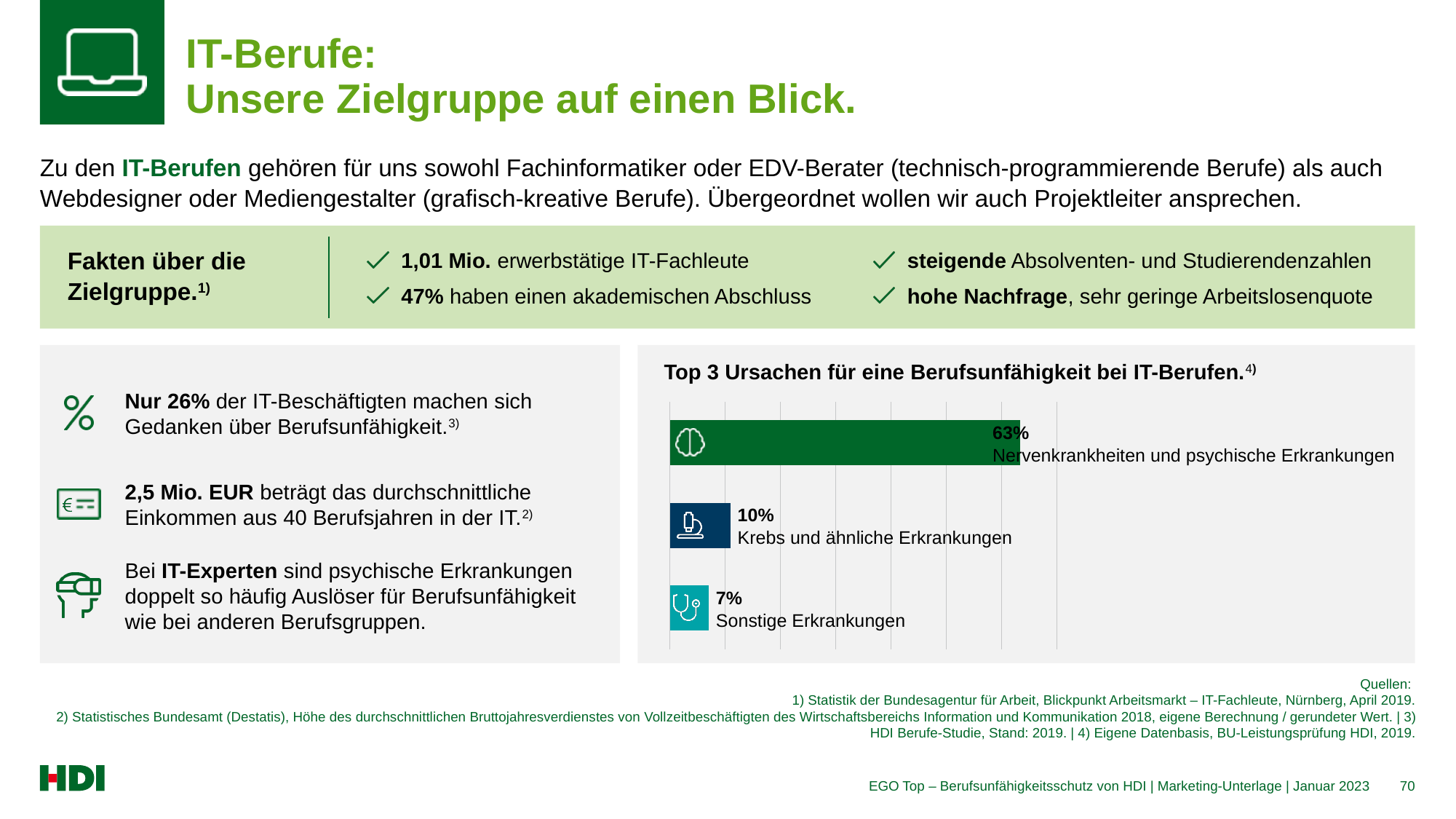
What is the value for Nervenkrankheiten und psychische Erkrankungen? 63% What is the difference between the values for Nervenkrankheiten und psychische Erkrankungen and Krebs und ähnliche Erkrankungen? 53% Which category has the highest value? Nervenkrankheiten und psychische Erkrankungen What is the value for Sonstige Erkrankungen? 7% How many categories are shown in the chart? 3 What is the difference between the values for Krebs und ähnliche Erkrankungen and Sonstige Erkrankungen? 3% What kind of chart is shown on the slide? Bar chart Which is larger, the value for Krebs und ähnliche Erkrankungen or the value for Sonstige Erkrankungen? Krebs und ähnliche Erkrankungen What colour is the bar for Nervenkrankheiten und psychische Erkrankungen? Dark green What is the title of the chart? Top 3 Ursachen für eine Berufsunfähigkeit bei IT-Berufen. What is the value for Krebs und ähnliche Erkrankungen? 10% Which category has the lowest value? Sonstige Erkrankungen